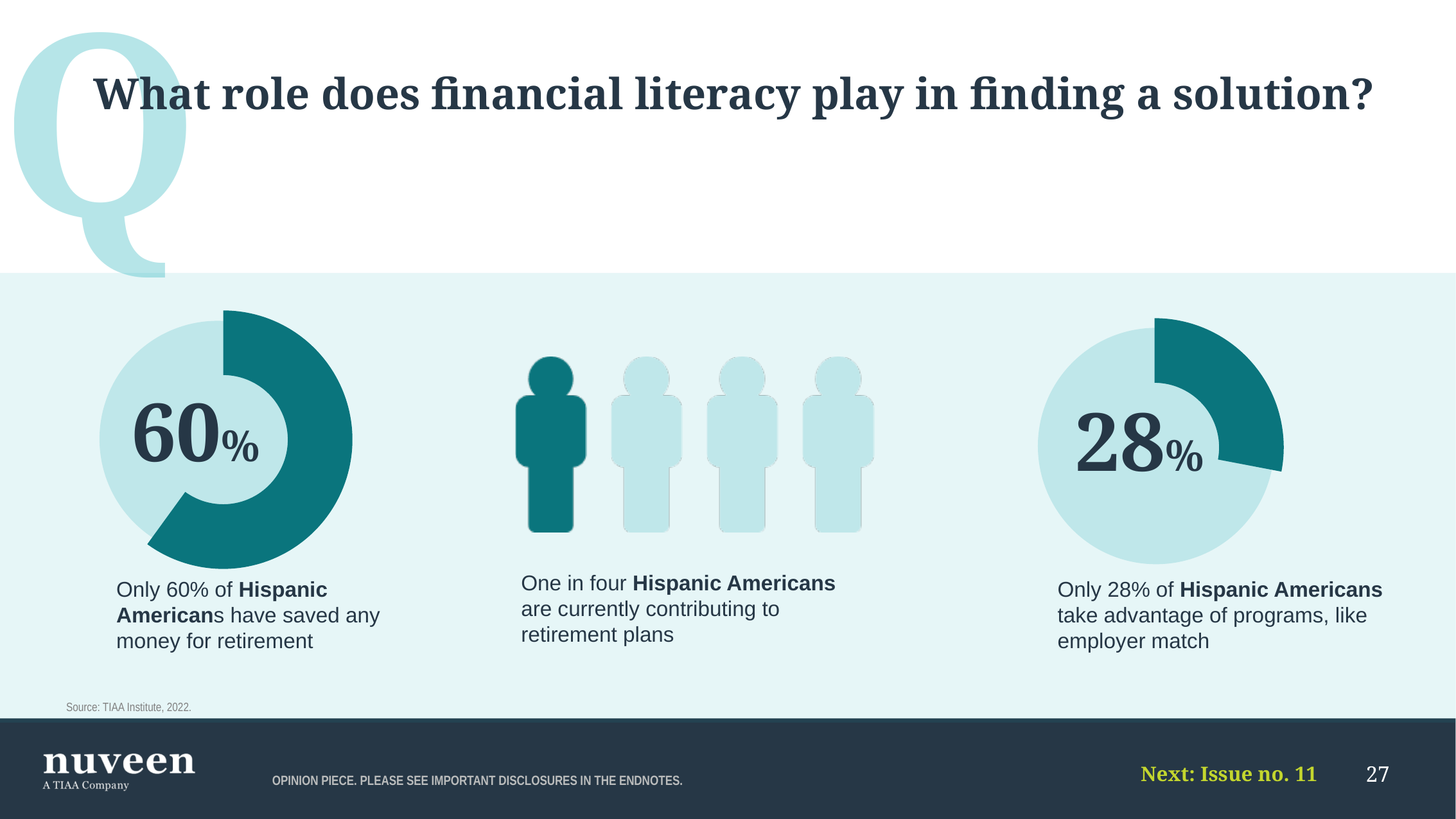
On the right donut chart, what percentage of Hispanic Americans take advantage of programs like employer match? 28% Which is larger: the percentage on the left donut chart or the percentage on the right donut chart? The left donut chart (60%) What kind of chart is used on the left and right sides of the slide to show the 60% and 28% figures? Donut chart What source is cited for the data on the slide? TIAA Institute, 2022 What is the difference between the percentage on the left donut chart and the percentage on the right donut chart? 32 percentage points In the middle pictogram, how many of the person icons are filled in dark teal? 1 In the middle pictogram, how many person icons are shown in total? 4 Is the value shown on the right donut chart greater or less than 50%? less According to the middle pictogram, what fraction of Hispanic Americans are currently contributing to retirement plans? One in four How many separate data visuals (donut charts and pictograms) are shown on the slide? 3 On the left donut chart, what percentage of Hispanic Americans have saved any money for retirement? 60% Is the value shown on the left donut chart greater or less than 50%? greater